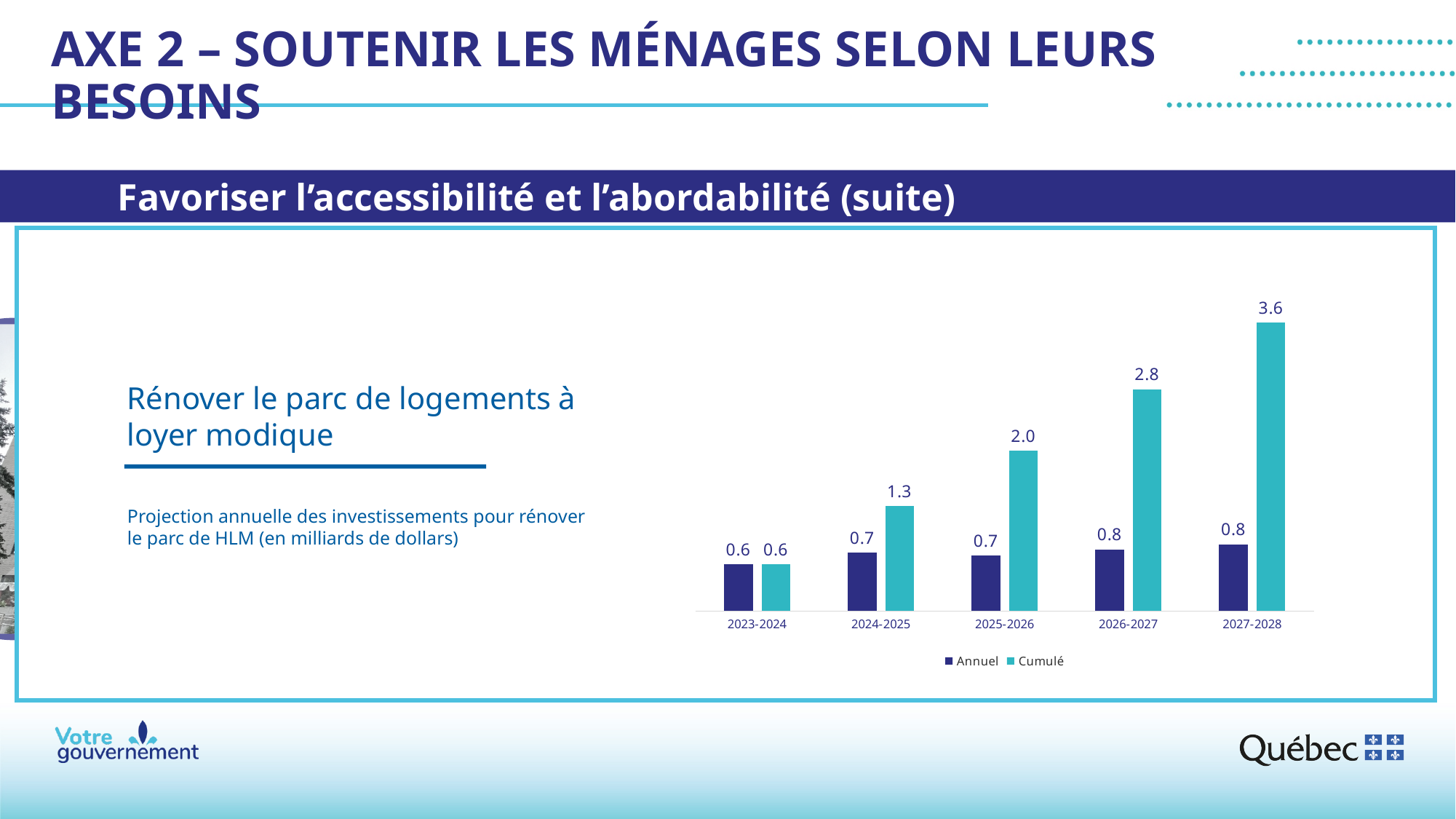
Which year has the highest Cumulé value? 2027-2028 Do the Cumulé values rise or fall from 2023-2024 to 2027-2028? Rise Which is larger for 2026-2027, the Annuel value or the Cumulé value? Cumulé How many year categories are shown on the x axis? 5 What is the Cumulé value for 2027-2028? 3.6 What kind of chart is shown on the slide? Bar chart Which year has the lowest Annuel value? 2023-2024 What are the two series named in the legend? Annuel and Cumulé What is the Cumulé value for 2025-2026? 2.0 What is the difference between the Cumulé values for 2027-2028 and 2026-2027? 0.8 What is the Annuel value for 2024-2025? 0.7 How many series does the legend list? 2